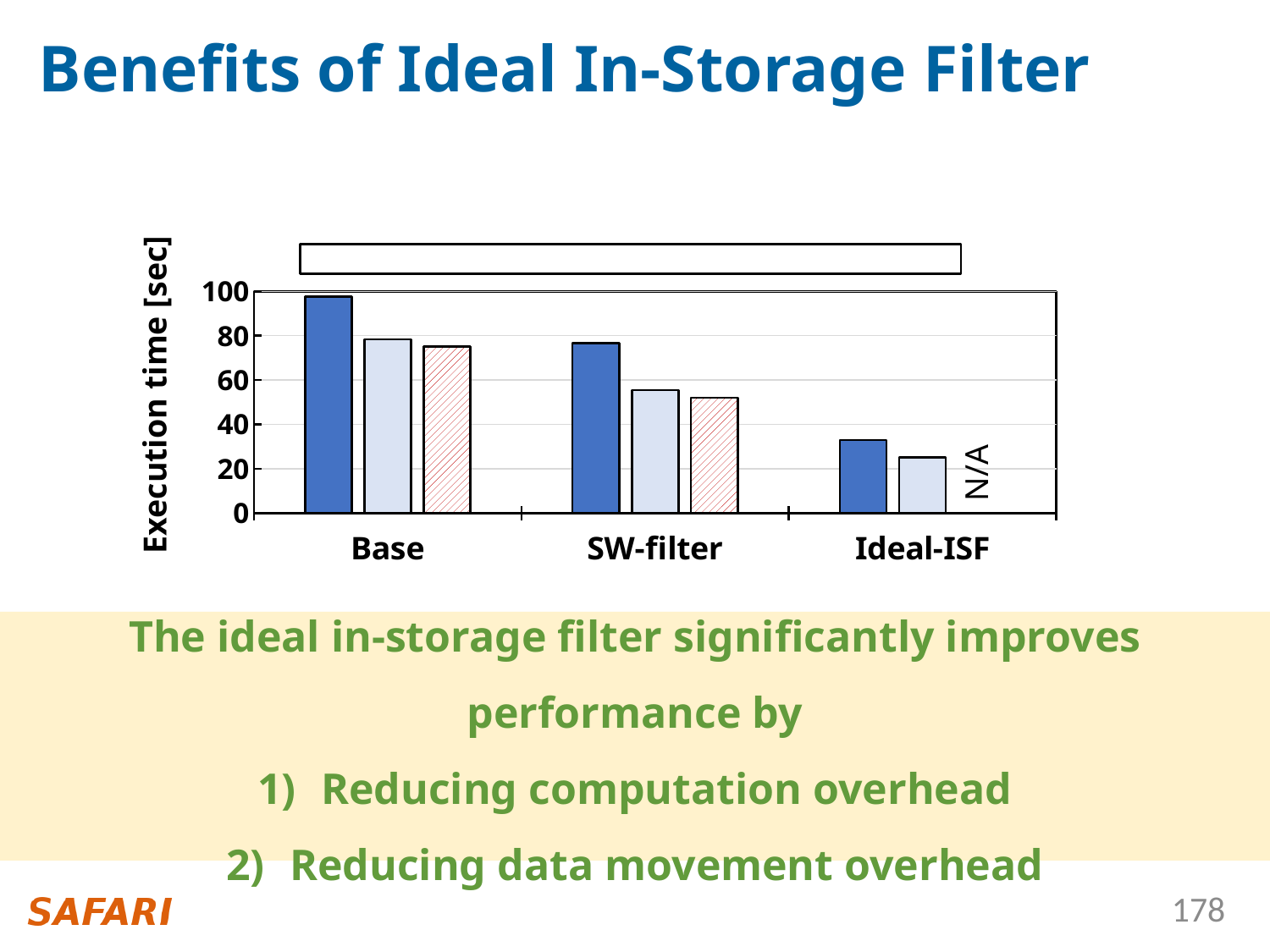
Is the value of the dark blue bar for Ideal-ISF greater or less than 40? less Which category has the tallest bar in the chart? Base What kind of chart is shown on the slide? bar chart What is shown in place of the red hatched bar for Ideal-ISF? N/A Is the value of the red hatched bar for SW-filter greater or less than 60? less Is the value of the light blue bar for Ideal-ISF greater or less than 40? less Which has the larger dark blue bar, Base or SW-filter? Base How many categories are shown on the x axis of the chart? 3 Do the dark blue bars rise or fall from Base to Ideal-ISF? fall Which category has the shortest bars in the chart? Ideal-ISF What is the label of the y axis of the chart? Execution time [sec]